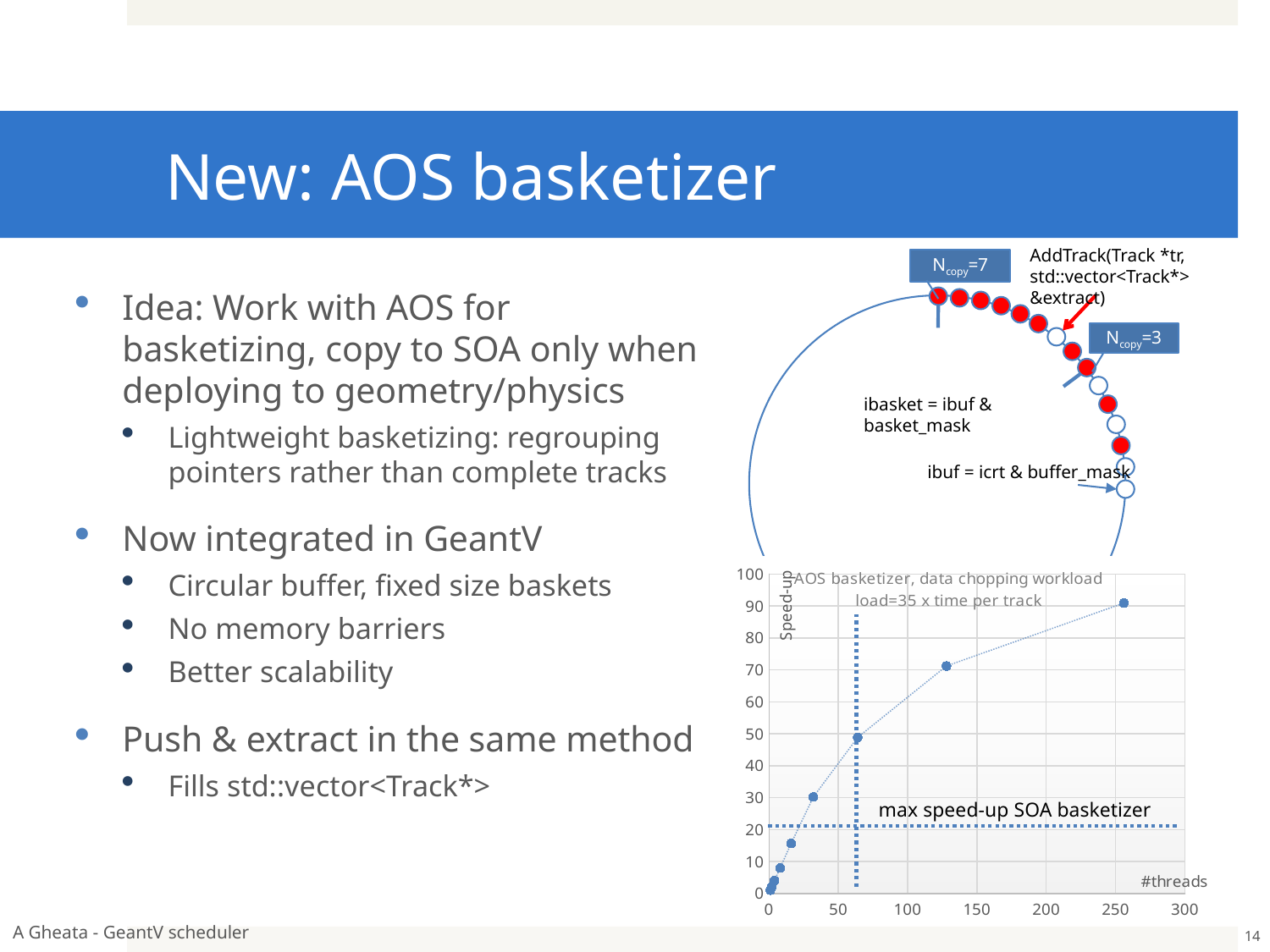
What is the label of the x axis of the chart? #threads Is the speed-up at about 65 threads greater or less than 40? greater Is the dashed horizontal line labelled 'max speed-up SOA basketizer' above or below 30 on the speed-up axis? below Is the speed-up at about 65 threads greater or less than 60? less What is the title of the chart on the slide? AOS basketizer, data chopping workload load=35 x time per track What is the highest value shown on the y axis of the chart? 100 Does the speed-up rise or fall as the number of threads increases? rise What kind of chart is shown on the slide? line chart with markers (scatter)